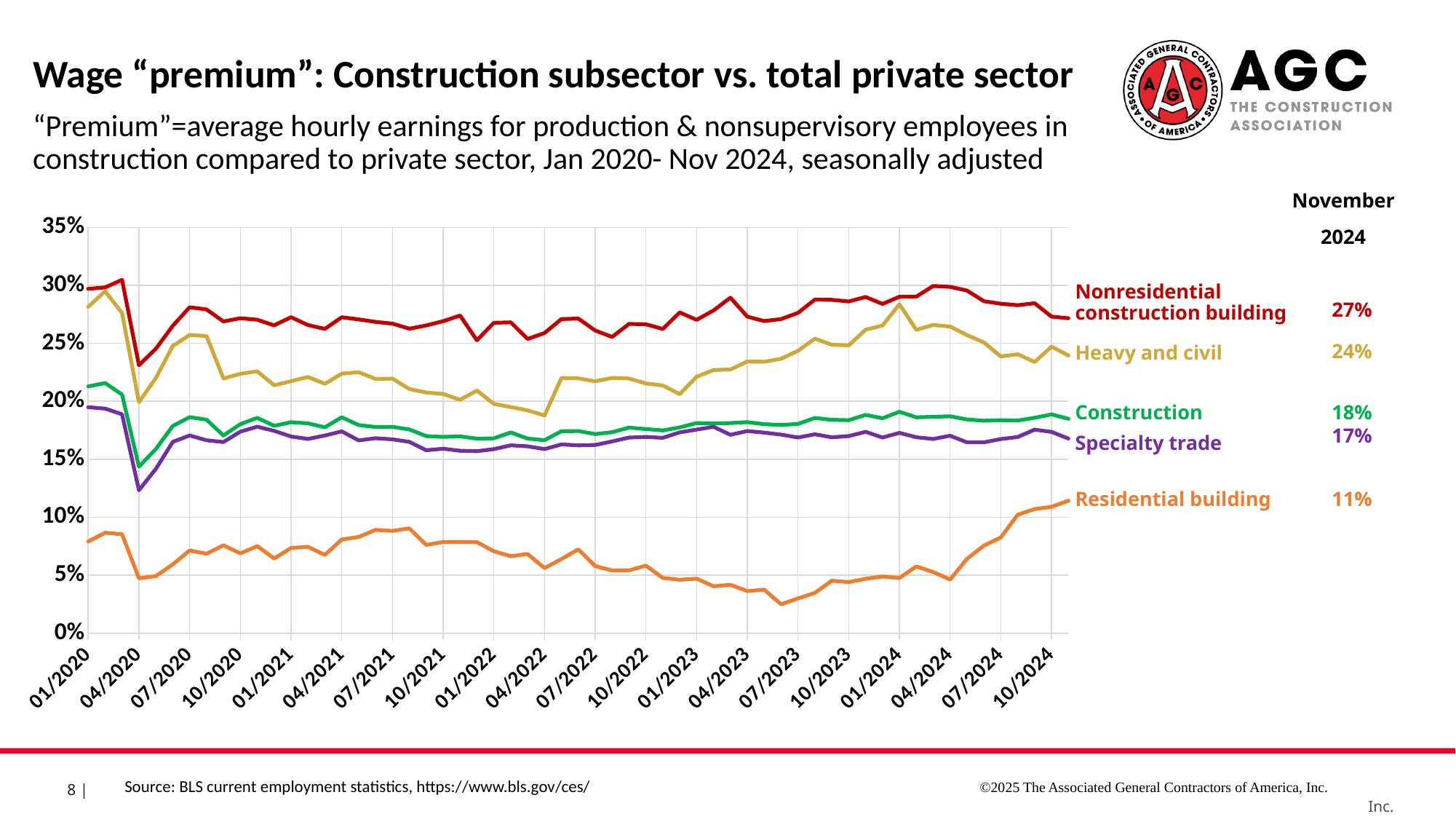
Which series has the lowest wage premium in November 2024? Residential building What is the November 2024 wage premium for Residential building? 11% What is the November 2024 wage premium for Heavy and civil? 24% What is the difference between the November 2024 wage premiums for Nonresidential construction building and Residential building? 16% Is the Residential building wage premium in 07/2023 greater or less than 5%? less Which series has the highest wage premium in November 2024? Nonresidential construction building Which is larger in November 2024: the wage premium for Heavy and civil or for Construction? Heavy and civil What is the November 2024 wage premium for Nonresidential construction building? 27% What is the November 2024 wage premium for Specialty trade? 17% What is the title of the chart on the slide? Wage "premium": Construction subsector vs. total private sector How many series are plotted on the chart? 5 What type of chart is shown on the slide? line chart